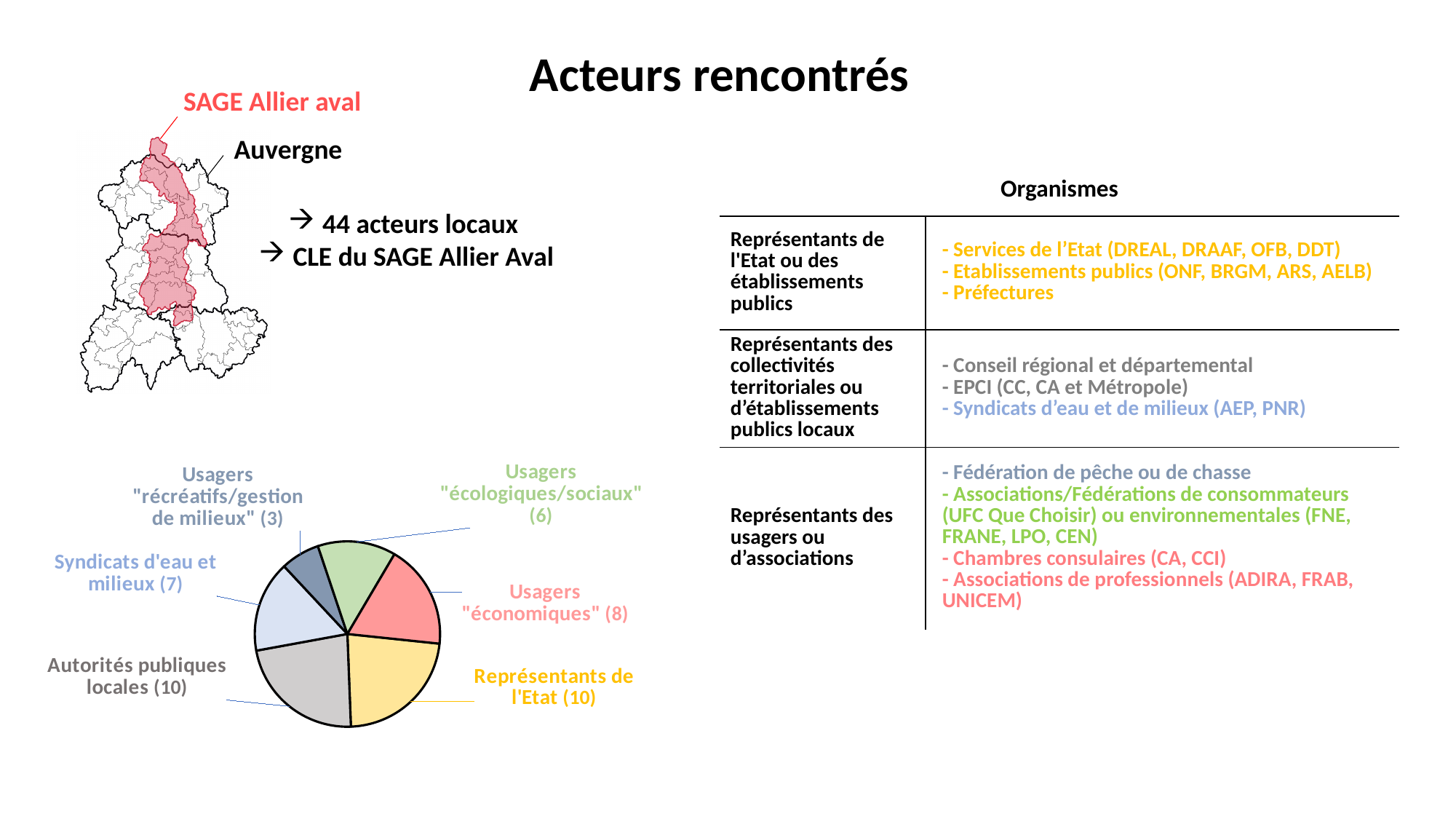
What colour is the Représentants de l'Etat slice in the pie chart? yellow How many slices does the pie chart have? 6 In the pie chart, what is the value for Syndicats d'eau et milieux? 7 In the pie chart, what is the value for Usagers "écologiques/sociaux"? 6 Which category in the pie chart has the smallest value? Usagers "récréatifs/gestion de milieux" In the pie chart, what is the difference between Usagers "économiques" and Usagers "écologiques/sociaux"? 2 What is the total of all the values shown in the pie chart? 44 In the pie chart, what is the difference between Autorités publiques locales and Usagers "récréatifs/gestion de milieux"? 7 In the pie chart, what is the value for Représentants de l'Etat? 10 In the pie chart, which is larger: Usagers "économiques" or Syndicats d'eau et milieux? Usagers "économiques" What kind of chart is shown at the bottom left of the slide? pie chart In the pie chart, how many actors are in the category Usagers "économiques"? 8